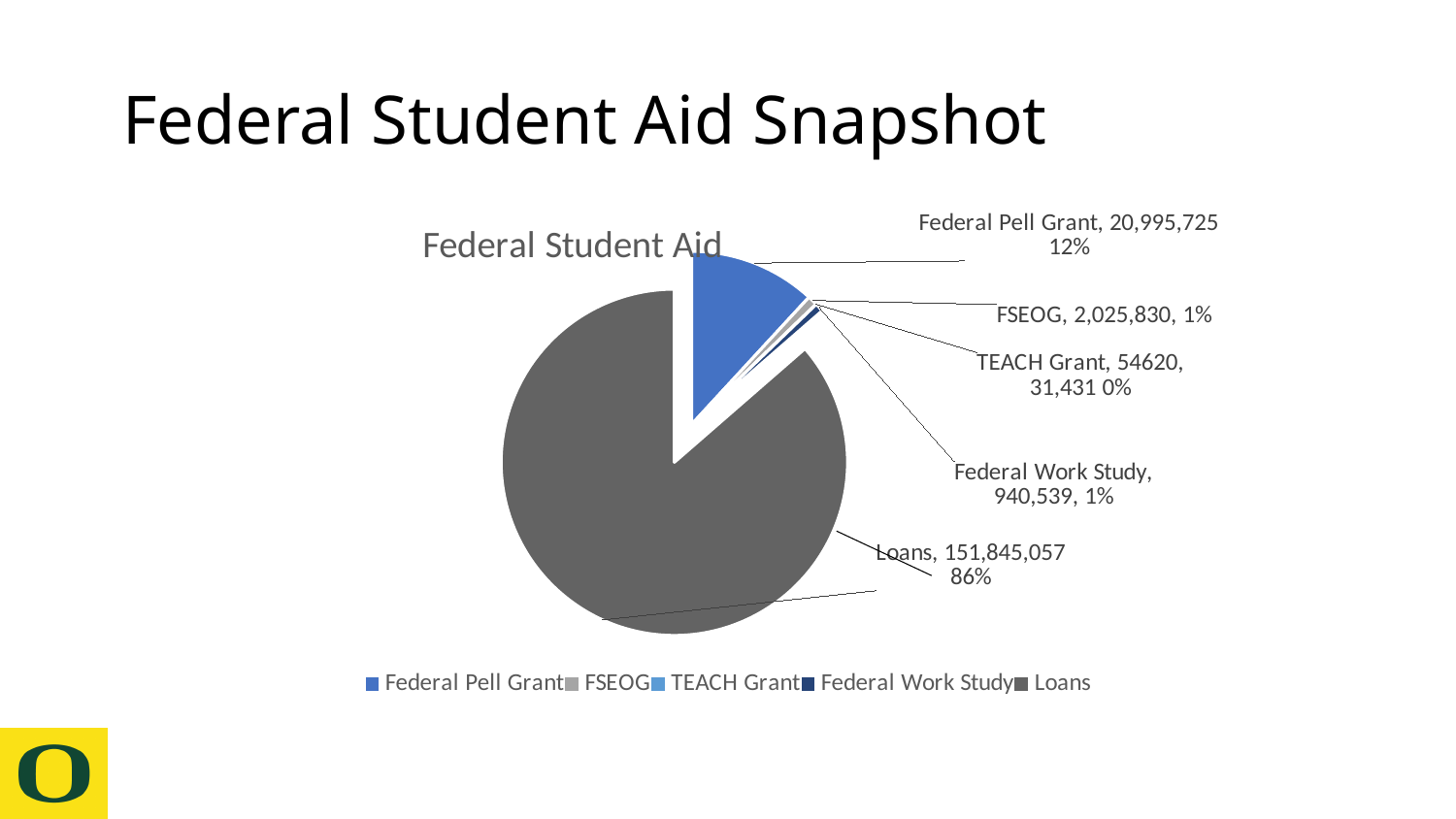
What is the value for FSEOG in the Federal Student Aid pie chart? 2,025,830 Which category has the largest slice in the Federal Student Aid pie chart? Loans Which category has the smallest slice in the Federal Student Aid pie chart? TEACH Grant What is the value for Federal Work Study in the Federal Student Aid pie chart? 940,539 What is the value for Loans in the Federal Student Aid pie chart? 151,845,057 What share of the Federal Student Aid pie does Loans represent? 86% What type of chart is shown on the slide? pie chart What is the difference between the Loans value and the Federal Pell Grant value? 130,849,332 What share of the Federal Student Aid pie does Federal Pell Grant represent? 12% How many categories are shown in the Federal Student Aid pie chart? 5 What is the value for Federal Pell Grant in the Federal Student Aid pie chart? 20,995,725 Which is larger, FSEOG or Federal Work Study? FSEOG